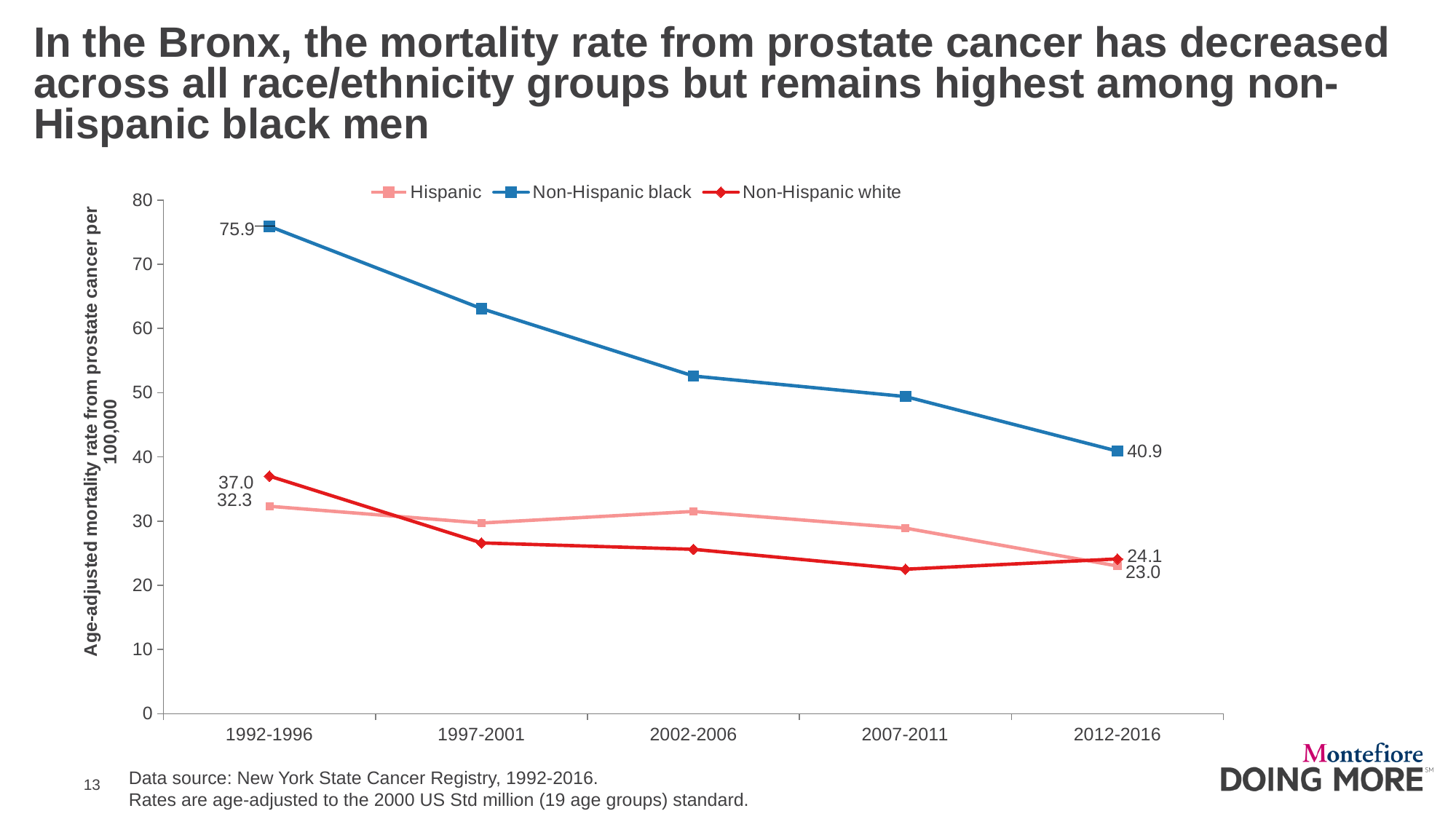
What is the mortality rate for Non-Hispanic white men in 2012-2016? 24.1 What is the age-adjusted prostate cancer mortality rate for Non-Hispanic black men in 2012-2016? 40.9 In 1992-1996, which group had the higher mortality rate: Hispanic or Non-Hispanic white? Non-Hispanic white What is the difference between the Non-Hispanic white mortality rate in 1992-1996 and in 2012-2016? 12.9 What kind of chart is shown on the slide? line chart What is the age-adjusted prostate cancer mortality rate for Non-Hispanic black men in 1992-1996? 75.9 By how much did the mortality rate for Non-Hispanic black men fall from 1992-1996 to 2012-2016? 35.0 What is the mortality rate for Hispanic men in 1992-1996? 32.3 Is the mortality rate for Non-Hispanic black men in 1997-2001 greater or less than 60? greater How many series does the legend list? 3 How many time periods are shown on the x axis? 5 Which race/ethnicity group has the highest mortality rate in 2012-2016? Non-Hispanic black